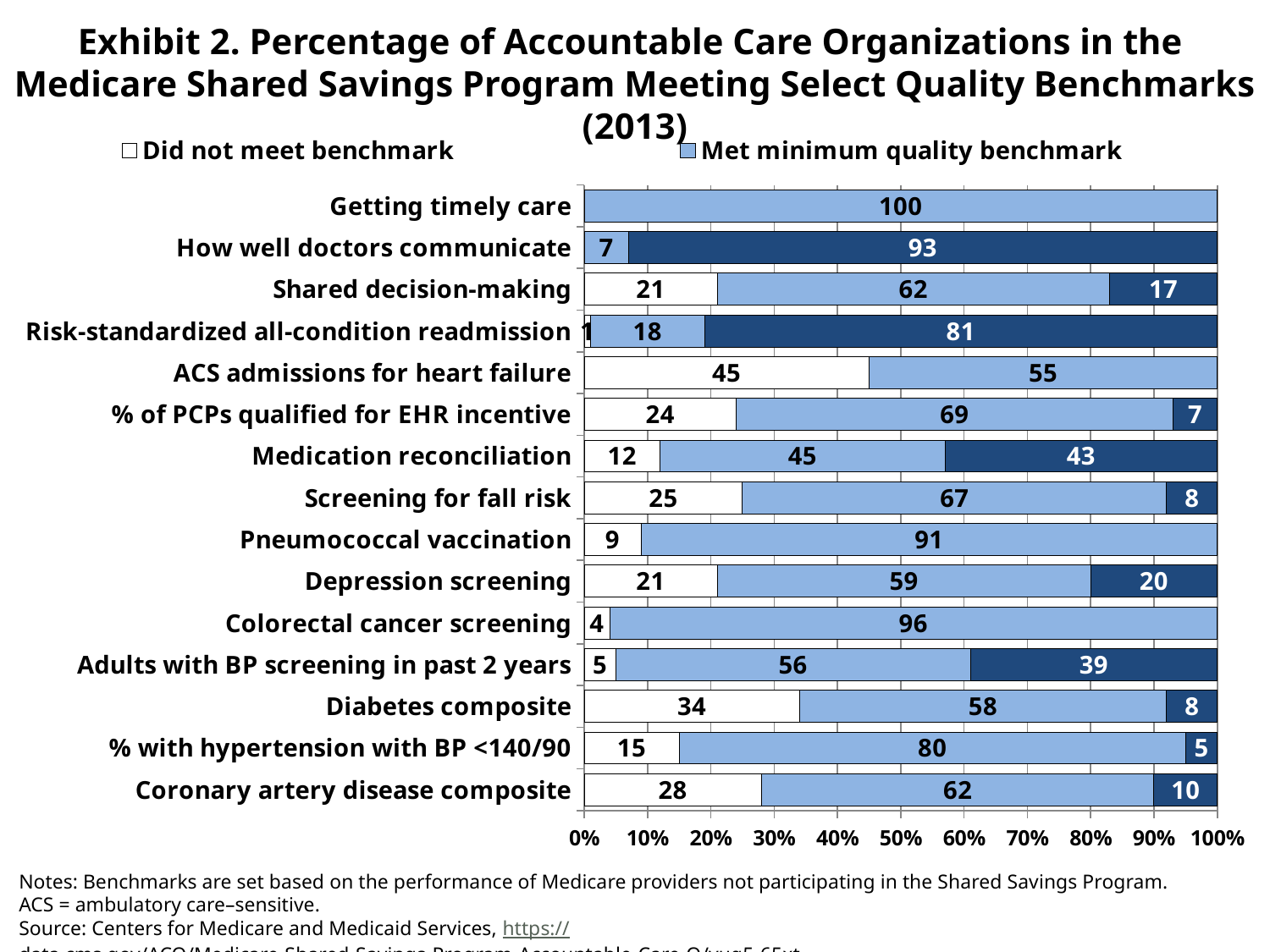
What percentage of ACOs did not meet the benchmark for ACS admissions for heart failure? 45 What year is given in the chart title? 2013 What percentage of ACOs met the minimum quality benchmark for Getting timely care? 100 What value is shown in the dark blue segment for Medication reconciliation? 43 Which has a larger 'Did not meet benchmark' value: Shared decision-making or Screening for fall risk? Screening for fall risk How many quality measures (categories) are listed on the chart? 15 What type of chart is shown on the slide? bar chart Which measure has the highest 'Did not meet benchmark' percentage? ACS admissions for heart failure What is the difference between the 'Did not meet benchmark' values for Diabetes composite and Coronary artery disease composite? 6 What is the 'Did not meet benchmark' value for Diabetes composite? 34 Which measure has the lowest 'Met minimum quality benchmark' percentage? How well doctors communicate What is the 'Met minimum quality benchmark' value for Pneumococcal vaccination? 91